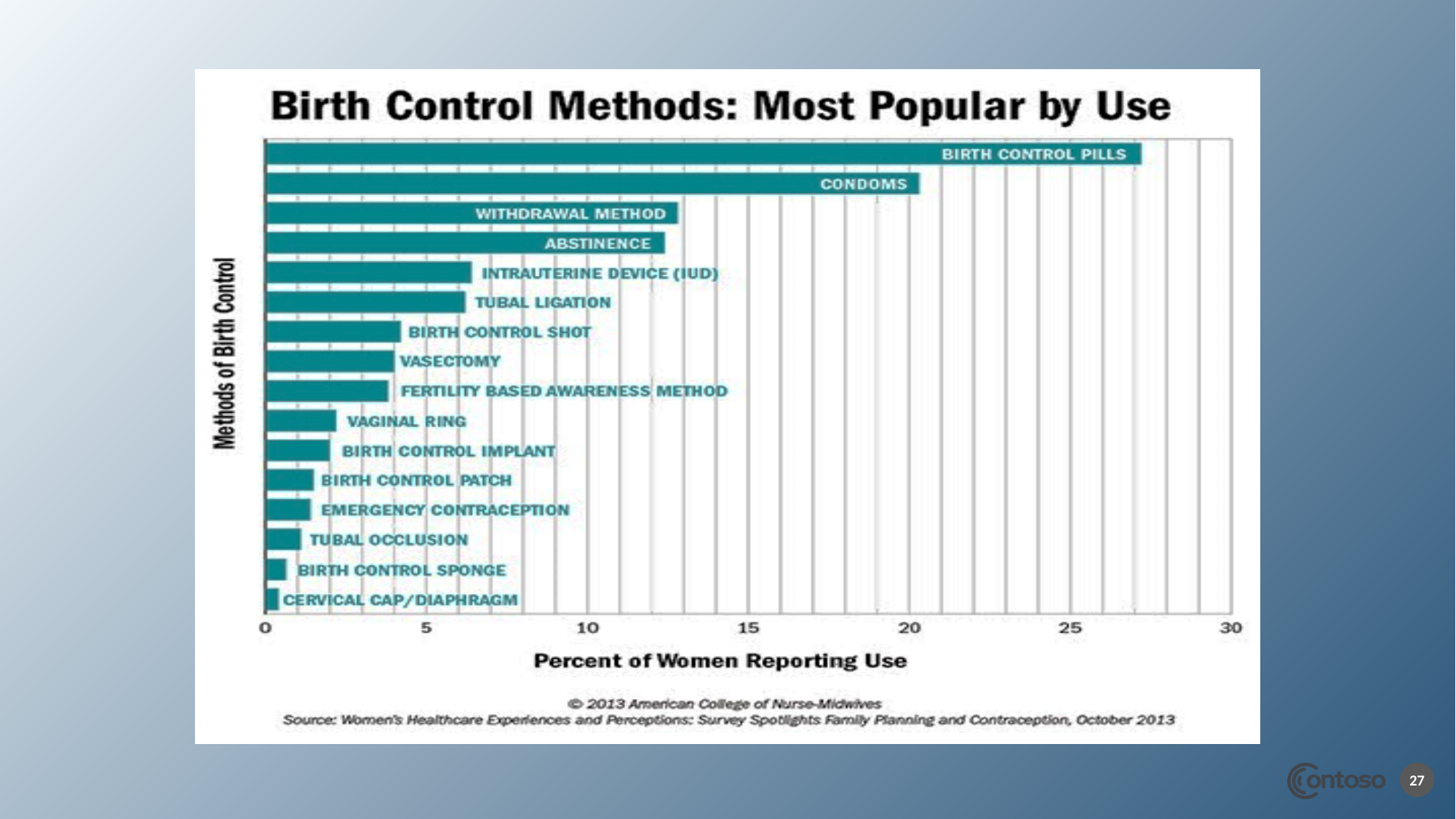
Is the value for Condoms greater or less than 25? less What is the label on the horizontal axis of the chart? Percent of Women Reporting Use Which birth control method has the highest percent of women reporting use? Birth Control Pills Is the value for Vaginal Ring greater or less than 5? less Is the value for Birth Control Pills greater or less than 25? greater How many birth control methods are plotted in the chart? 16 What type of chart is shown on the slide? Bar chart What is the title of the chart? Birth Control Methods: Most Popular by Use Which birth control method has the lowest percent of women reporting use? Cervical Cap/Diaphragm Which has a higher percent of women reporting use, Intrauterine Device (IUD) or Birth Control Patch? Intrauterine Device (IUD) Which has a higher percent of women reporting use, Condoms or Abstinence? Condoms